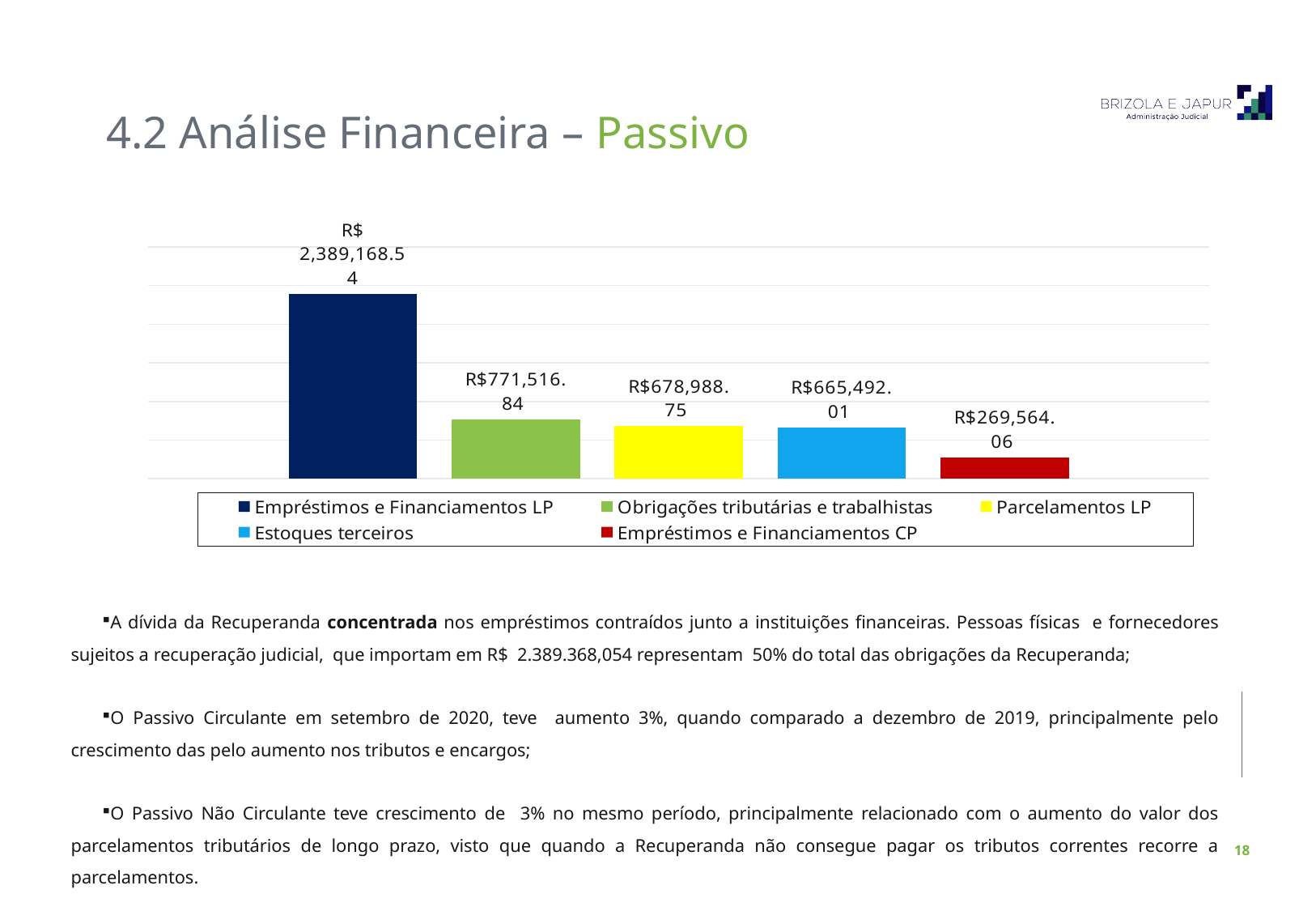
What is the value for Estoques terceiros? R$665,492.01 How many series does the legend list? 5 Which is larger, Parcelamentos LP or Estoques terceiros? Parcelamentos LP What kind of chart is shown on the slide? Bar chart What is the value for Empréstimos e Financiamentos LP? R$ 2,389,168.54 What is the difference between Empréstimos e Financiamentos LP and Empréstimos e Financiamentos CP? R$2,119,604.48 What is the value for Empréstimos e Financiamentos CP? R$269,564.06 What is the value for Obrigações tributárias e trabalhistas? R$771,516.84 Which category has the highest value? Empréstimos e Financiamentos LP What is the value for Parcelamentos LP? R$678,988.75 Which category has the lowest value? Empréstimos e Financiamentos CP What is the difference between Obrigações tributárias e trabalhistas and Parcelamentos LP? R$92,528.09